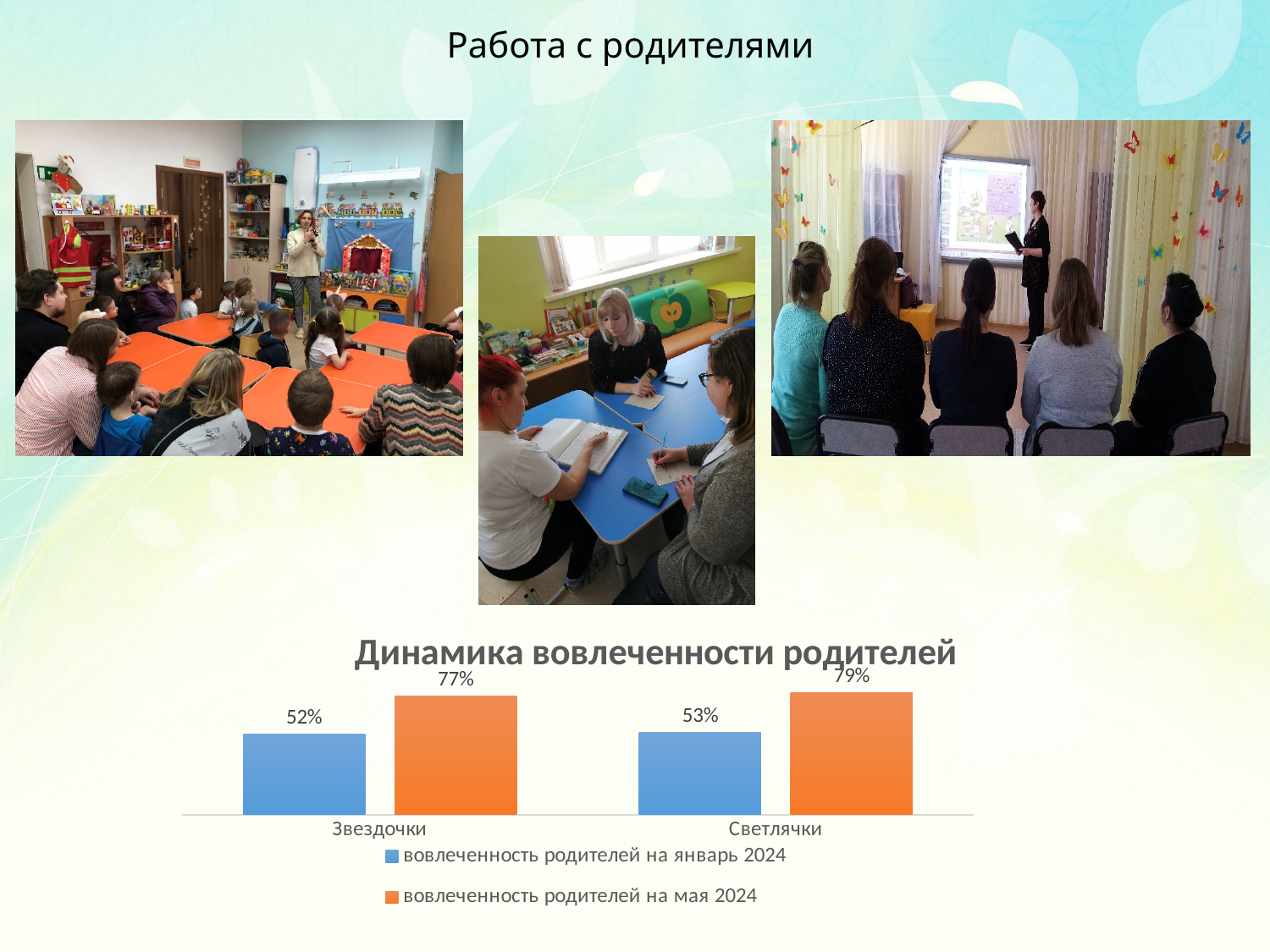
How many series does the chart legend list? 2 What is the value of 'вовлеченность родителей на январь 2024' for Светлячки? 53% What is the value of 'вовлеченность родителей на январь 2024' for Звездочки? 52% What is the title of the chart on the slide? Динамика вовлеченности родителей What is the difference between the May 2024 and January 2024 values for Светлячки? 26% What is the difference between the May 2024 and January 2024 values for Звездочки? 25% What is the value of 'вовлеченность родителей на мая 2024' for Светлячки? 79% Which category has the highest value for 'вовлеченность родителей на мая 2024'? Светлячки Which colour represents 'вовлеченность родителей на мая 2024' in the chart? orange What is the value of 'вовлеченность родителей на мая 2024' for Звездочки? 77% What type of chart is shown on the slide? bar chart How many categories are shown on the x axis of the chart? 2